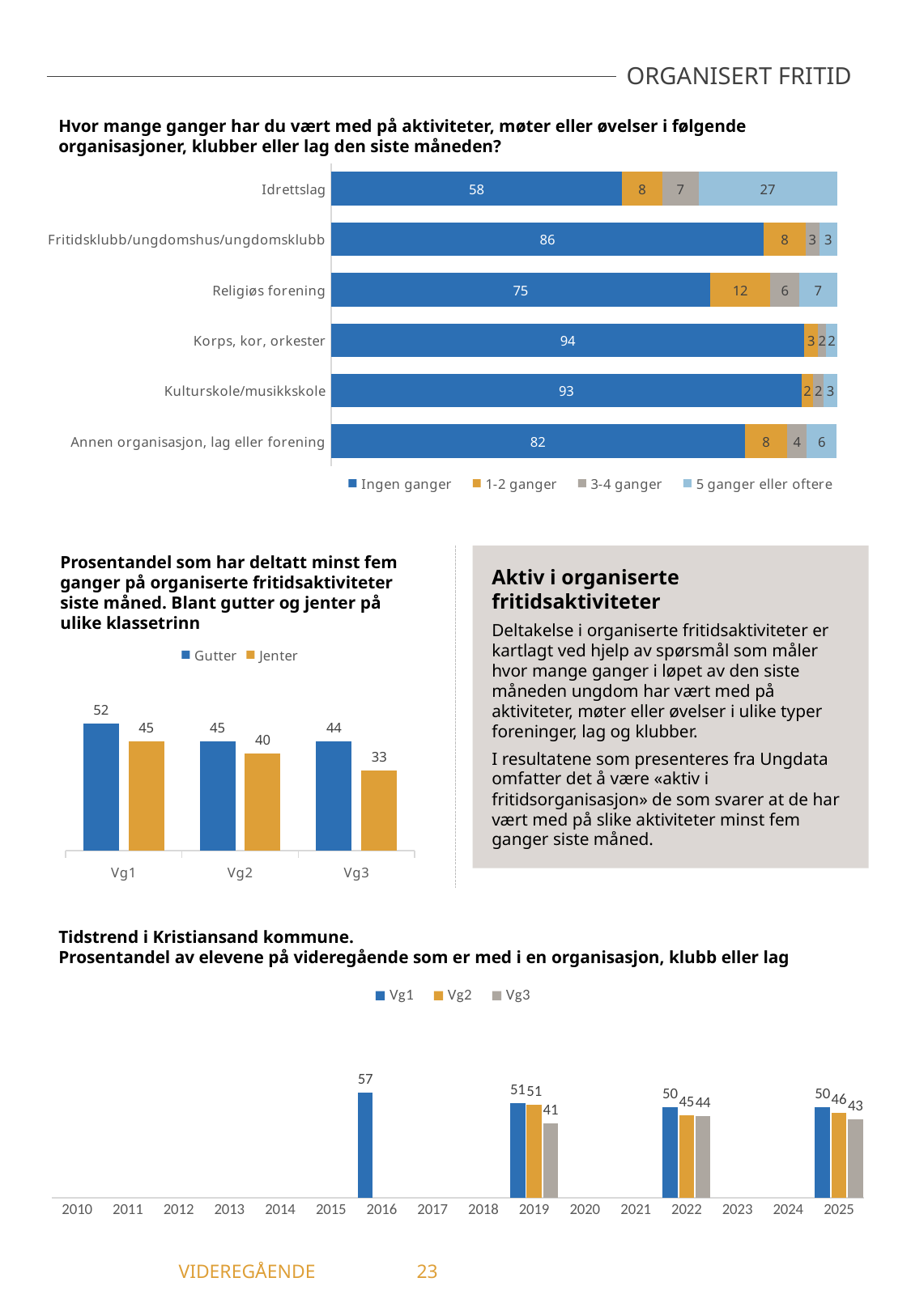
In the bottom chart ("Tidstrend i Kristiansand kommune"), what is the value for Vg1 in 2016? 57 In the top chart ("Hvor mange ganger har du vært med på aktiviteter..."), what is the value for "Ingen ganger" for Idrettslag? 58 In the middle-left chart ("Prosentandel som har deltatt minst fem ganger..."), do the values for Gutter rise or fall from Vg1 to Vg3? fall In the top chart ("Hvor mange ganger har du vært med på aktiviteter..."), how many series does the legend list? 4 In the middle-left chart ("Prosentandel som har deltatt minst fem ganger..."), what is the value for Jenter at Vg3? 33 In the top chart ("Hvor mange ganger har du vært med på aktiviteter..."), what is the value for "5 ganger eller oftere" for Religiøs forening? 7 In the bottom chart ("Tidstrend i Kristiansand kommune"), which is larger in 2022: Vg2 or Vg3? Vg2 In the top chart ("Hvor mange ganger har du vært med på aktiviteter..."), what is the total of the stacked bar for Idrettslag? 100 What kind of chart is the bottom chart ("Tidstrend i Kristiansand kommune")? bar chart In the top chart ("Hvor mange ganger har du vært med på aktiviteter..."), how many categories are shown? 6 In the top chart ("Hvor mange ganger har du vært med på aktiviteter..."), which category has the highest value for "Ingen ganger"? Korps, kor, orkester In the middle-left chart ("Prosentandel som har deltatt minst fem ganger..."), what is the difference between Gutter and Jenter at Vg1? 7